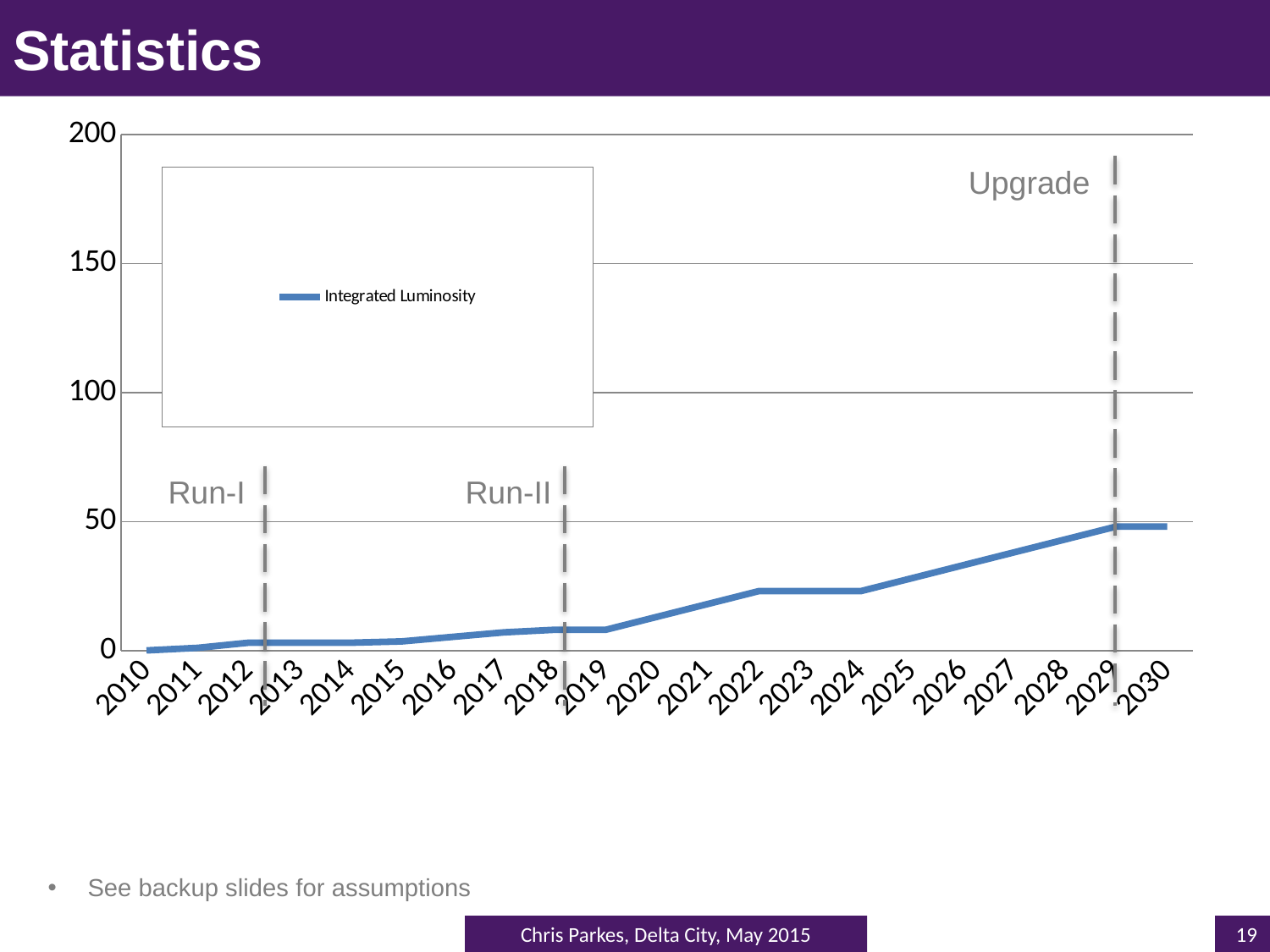
Which year has the lowest Integrated Luminosity value? 2010 How many series does the legend list? 1 Do the Integrated Luminosity values rise or fall from 2010 to 2030? rise What label is written next to the dashed vertical line at 2029? Upgrade Is the Integrated Luminosity value for 2024 greater or less than 50? less Is the Integrated Luminosity value for 2030 greater or less than 100? less What kind of chart is shown on the slide? line chart What is the name of the series shown in the legend? Integrated Luminosity How many years are shown along the x axis? 21 Is the Integrated Luminosity value for 2019 greater or less than 50? less Which year has the larger Integrated Luminosity value, 2019 or 2024? 2024 Which year has the larger Integrated Luminosity value, 2022 or 2028? 2028